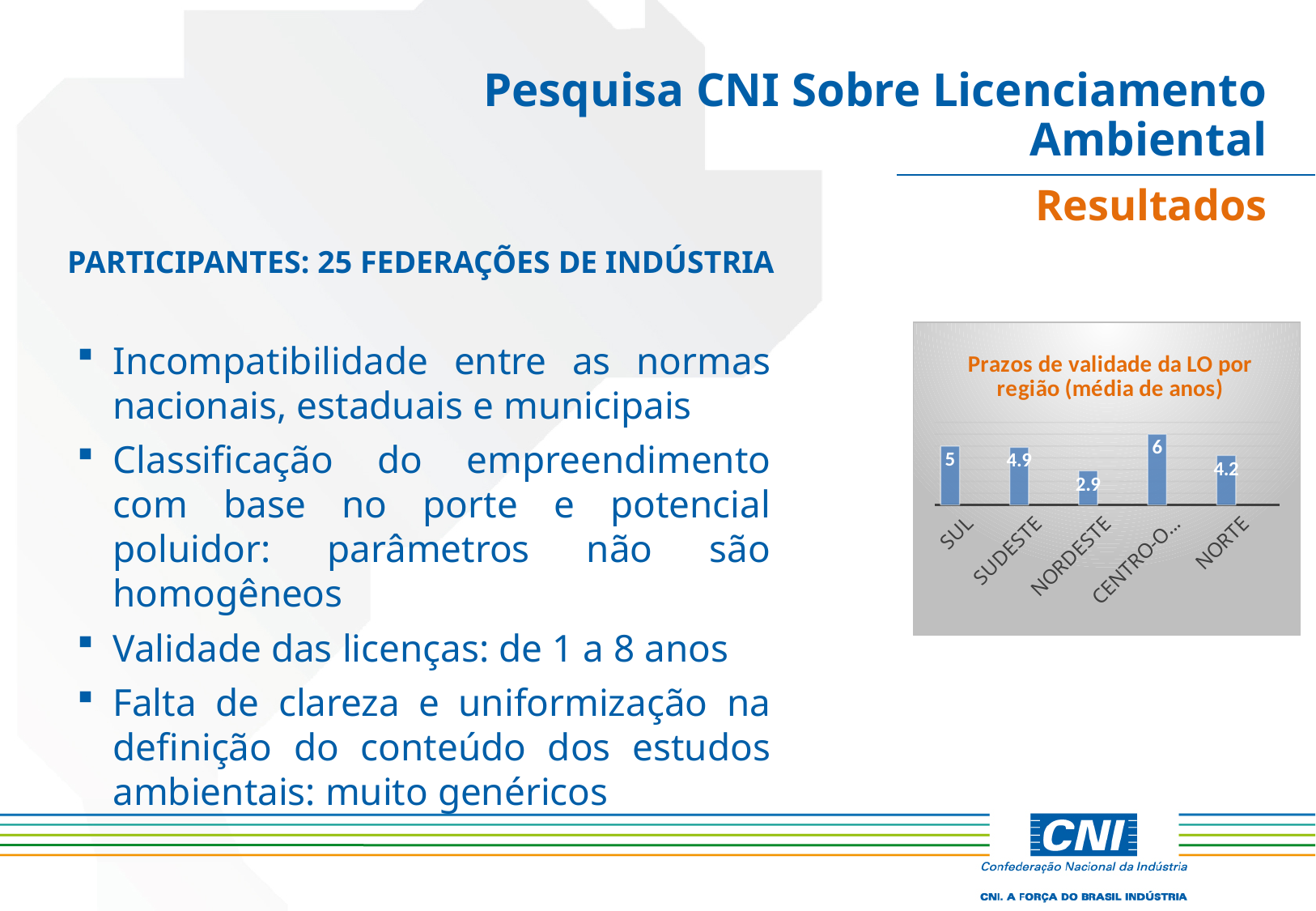
What is the value for SUL in the chart 'Prazos de validade da LO por região (média de anos)'? 5 What is the value for NORDESTE in the chart? 2.9 How many regions are shown in the chart? 5 What kind of chart is shown on the slide? Bar chart What is the value for NORTE in the chart? 4.2 What is the value for SUDESTE in the chart? 4.9 Which is larger, the value for SUL or the value for NORTE? SUL Which region has the lowest value in the chart? NORDESTE What is the title of the chart on the slide? Prazos de validade da LO por região (média de anos) What is the difference between the values for SUL and NORDESTE? 2.1 Which region has the highest value in the chart? CENTRO-OESTE What is the difference between the values for SUDESTE and NORTE? 0.7